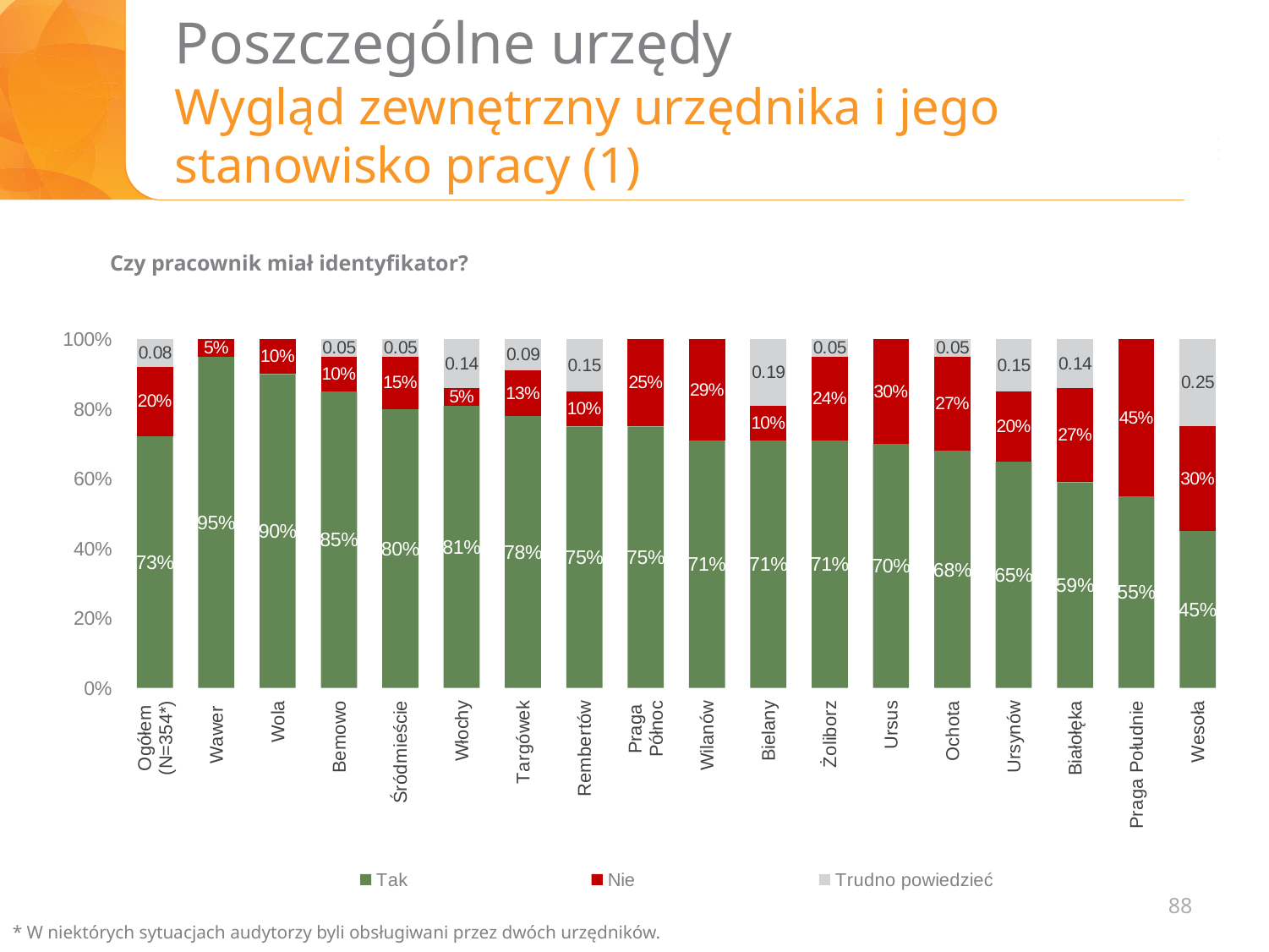
Which office has the lowest "Tak" share? Wesoła What is the "Nie" value for Praga Południe? 45% How many series does the legend list? 3 Which has a larger "Nie" share, Ursus or Ochota? Ursus What type of chart is shown on the slide? Stacked bar chart What is the difference between the "Tak" values for Wawer and Wesoła? 50 percentage points How many offices (categories) are shown on the x axis? 18 Which office has the highest "Tak" share? Wawer What percentage of respondents answered "Tak" for Wawer? 95% What is the "Tak" value for Ogółem (N=354*)? 73% What is the "Trudno powiedzieć" value shown for Wesoła? 0.25 Which office has the highest "Nie" share? Praga Południe